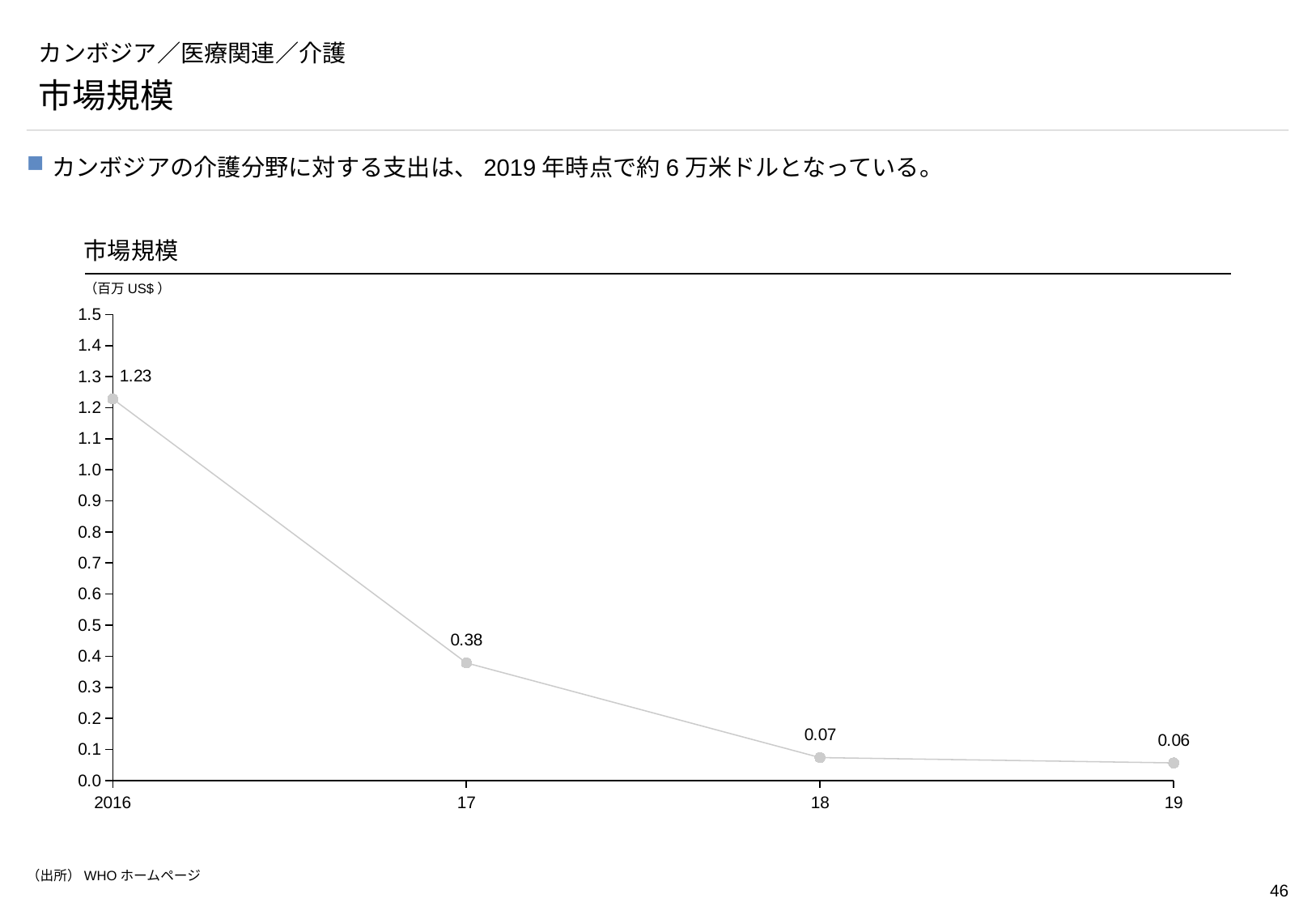
How many data points are plotted on the chart? 4 Do the values rise or fall from 2016 to 19? fall What is the difference between the 17 value and the 18 value? 0.31 What is the market size value for 2016? 1.23 What is the market size value for 17 (2017)? 0.38 Which year has the highest market size value? 2016 Which is larger, the value for 2016 or the value for 17? 2016 What kind of chart is shown on the slide? line chart Which year has the lowest market size value? 19 What is the difference between the 2016 value and the 17 value? 0.85 What is the market size value for 18 (2018)? 0.07 What is the market size value for 19 (2019)? 0.06